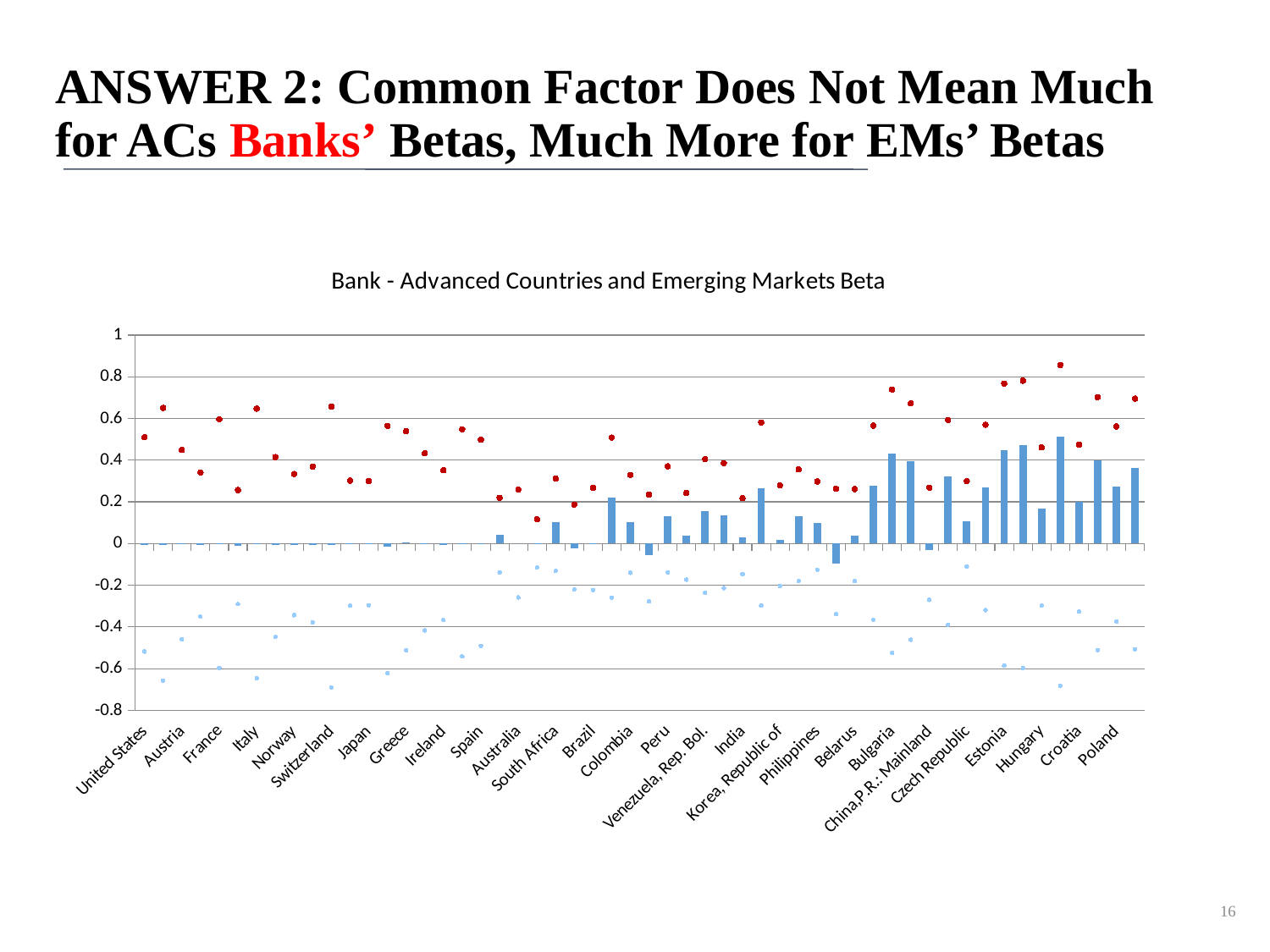
Is the red dot value for Switzerland greater or less than 0.6? greater Is the bar value for Estonia greater or less than 0.4? greater Is the red dot value for Croatia greater or less than 0.8? less Which has the larger bar value, Estonia or United States? Estonia What kind of chart is shown on the slide? bar chart What is the title of the chart? Bank - Advanced Countries and Emerging Markets Beta What is the lowest value shown on the vertical axis? -0.8 Which has the larger bar value, Bulgaria or Spain? Bulgaria